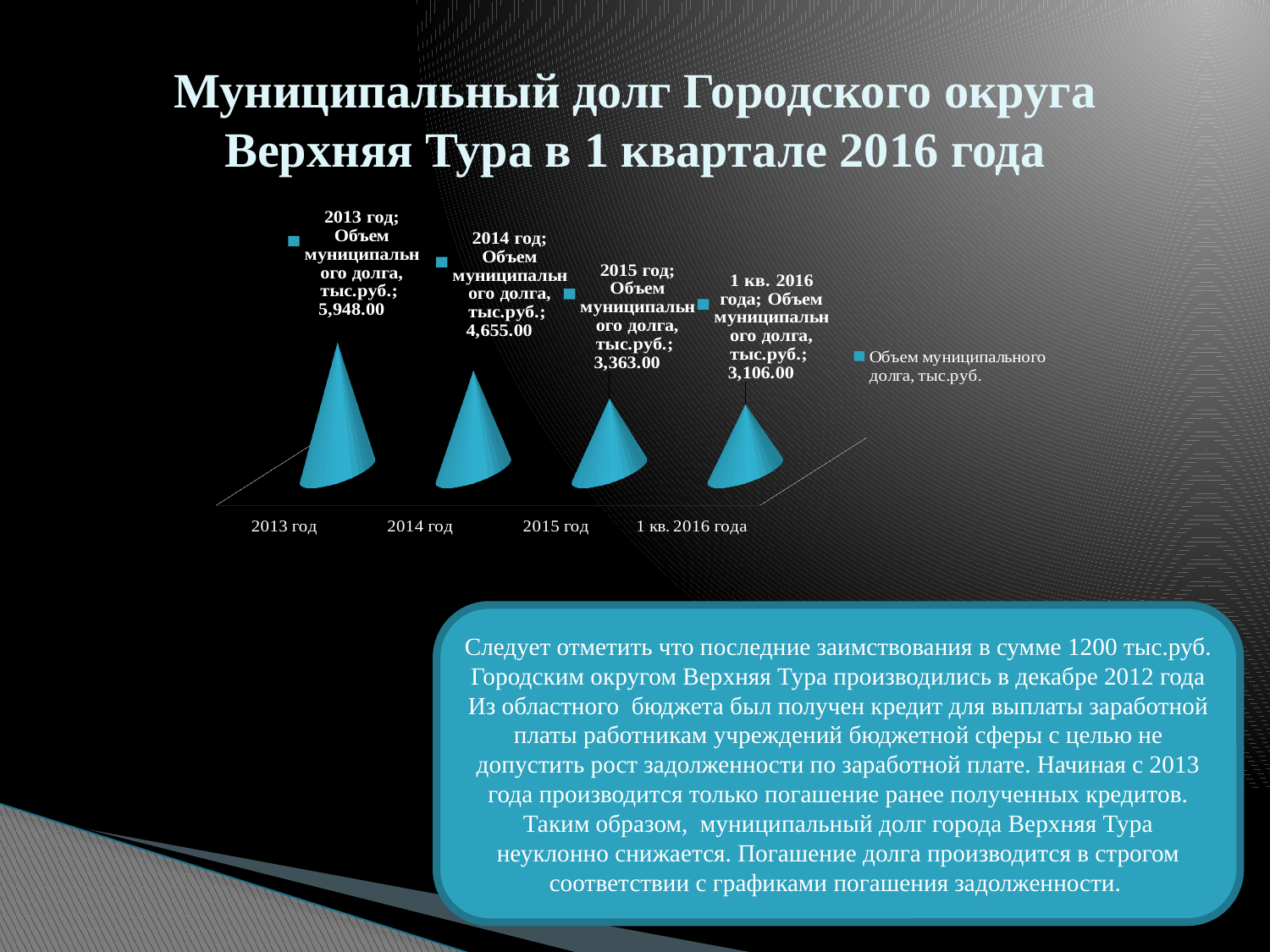
What is the difference between the values for 2013 год and 2014 год? 1,293.00 Do the values rise or fall from 2013 год to 1 кв. 2016 года? fall What is the value for 2015 год? 3,363.00 What is the value for 2014 год? 4,655.00 Which is larger, the value for 2014 год or the value for 2015 год? 2014 год What is the value for 2013 год? 5,948.00 How many series does the legend list? 1 What is the difference between the values for 2015 год and 1 кв. 2016 года? 257.00 How many categories are shown on the chart? 4 What is the value for 1 кв. 2016 года? 3,106.00 Which category has the lowest value? 1 кв. 2016 года Which category has the highest value? 2013 год